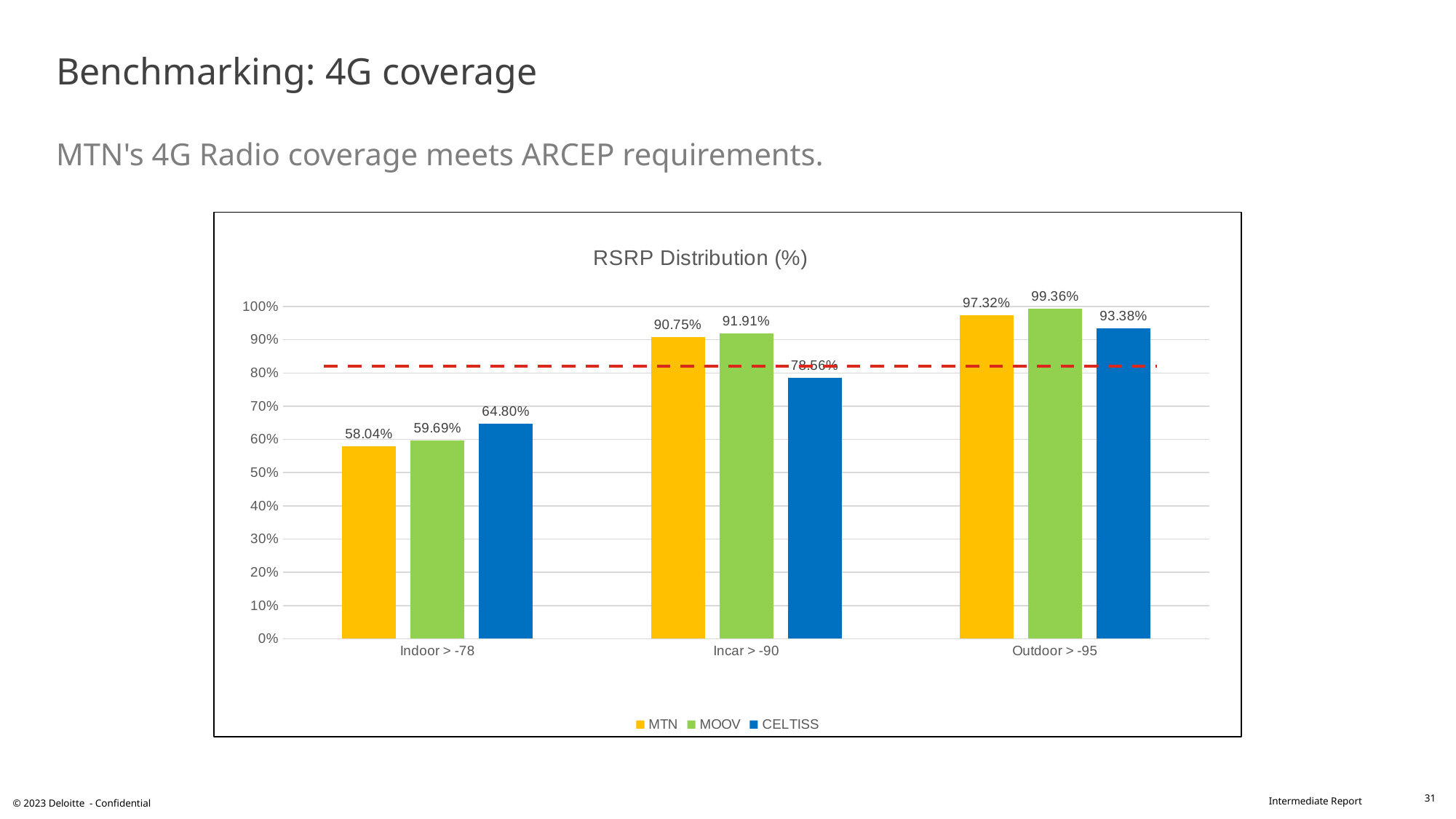
How many series does the legend of the RSRP Distribution chart list? 3 In the Incar > -90 category, which is larger: the value for MTN or the value for MOOV? MOOV What is the value for MTN in the Indoor > -78 category? 58.04% What is the value for MOOV in the Outdoor > -95 category? 99.36% Which operator has the lowest value in the Indoor > -78 category? MTN What is the value for MTN in the Incar > -90 category? 90.75% How many categories are shown on the x axis of the RSRP Distribution chart? 3 Which operator has the highest value in the Outdoor > -95 category? MOOV In the Outdoor > -95 category, how much higher is MOOV's value than MTN's? 2.04% What is the value for CELTISS in the Indoor > -78 category? 64.80% Is the value for CELTISS in the Incar > -90 category greater or less than 90%? less What kind of chart is shown on the slide? bar chart